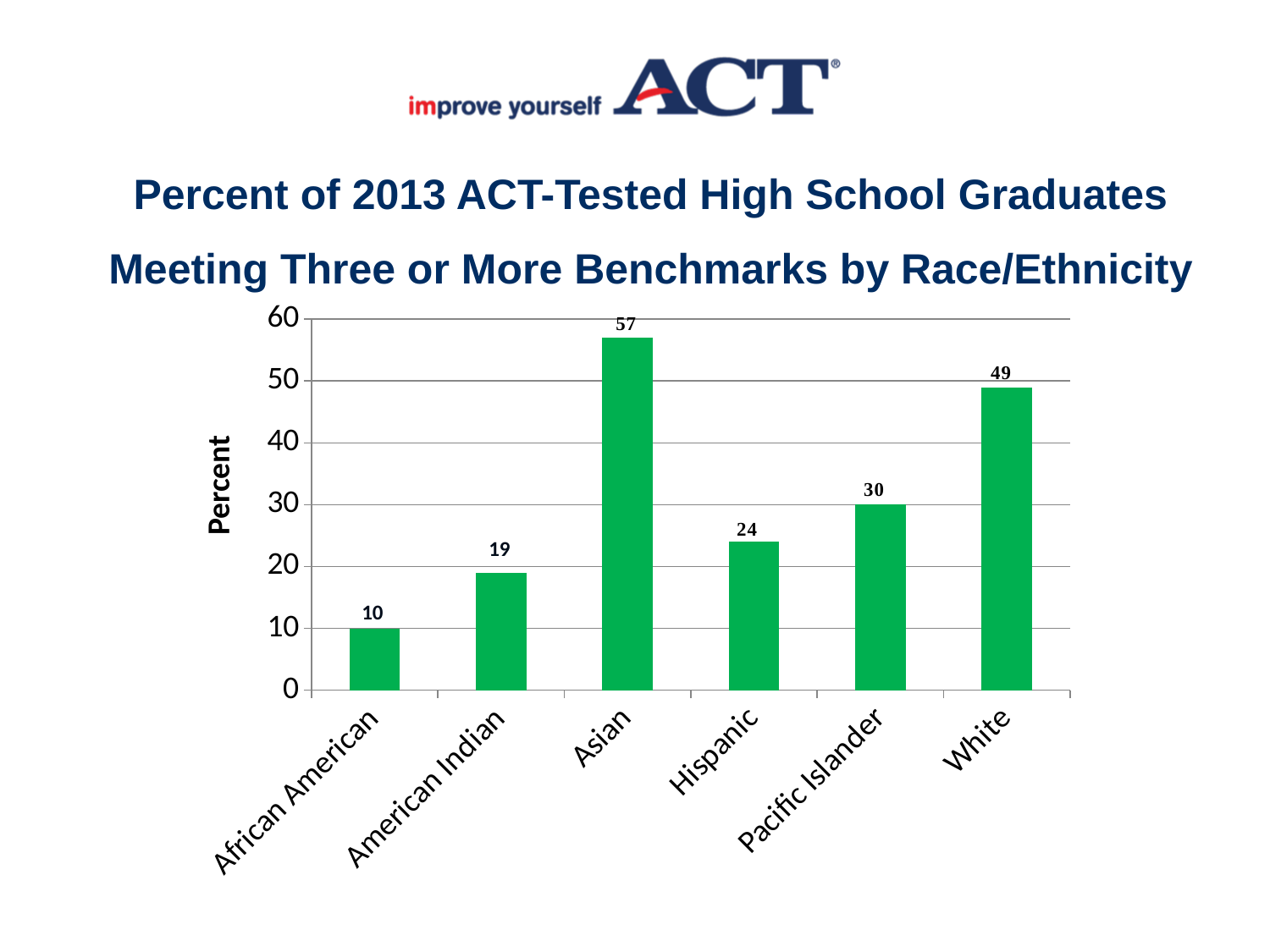
What is the label on the vertical axis of the chart? Percent Which is larger, the value for American Indian or the value for Hispanic graduates? Hispanic Which race/ethnicity group has the highest percent meeting three or more benchmarks? Asian What is the difference between the values for White and African American graduates? 39 Is the value for Pacific Islander graduates greater or less than 40? less Which race/ethnicity group has the lowest percent meeting three or more benchmarks? African American What percent of Asian 2013 ACT-tested graduates met three or more benchmarks? 57 What is the value shown for Hispanic graduates? 24 What is the value shown for Pacific Islander graduates? 30 What is the difference between the values for Asian and White graduates? 8 How many race/ethnicity categories are shown on the chart? 6 What kind of chart is shown on the slide? bar chart